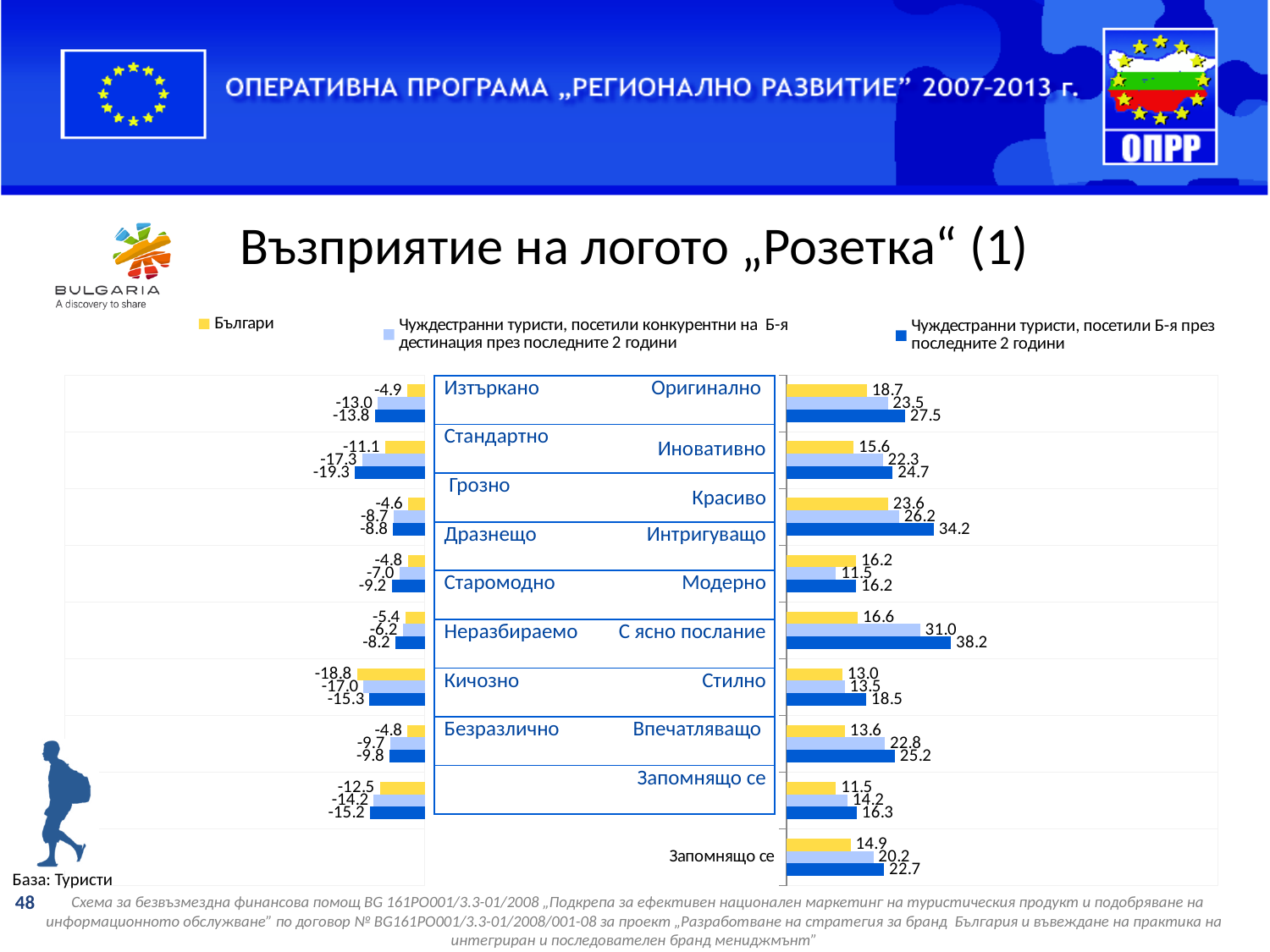
In the right-hand chart, what is the value for Българи for Оригинално? 18.7 Which series is shown in yellow according to the legend? Българи What kind of chart is used on the slide to show perception of the "Розетка" logo? bar chart How many series does the legend list? 3 In the left-hand chart (negative attributes), what is the lowest (most negative) value shown? -19.3 In the right-hand chart (positive attributes), what is the highest value shown? 38.2 In the right-hand chart, what is the value for Българи in the bottom row labelled Запомнящо се? 14.9 In the right-hand chart, what is the value for Чуждестранни туристи, посетили Б-я през последните 2 години for Оригинално? 27.5 In the right-hand chart, what is the difference between the value for Чуждестранни туристи, посетили Б-я през последните 2 години and the value for Българи for Оригинално? 8.8 In the right-hand chart, what is the value for Чуждестранни туристи, посетили Б-я през последните 2 години in the bottom row labelled Запомнящо се? 22.7 In the right-hand chart, for Оригинално, which series has the larger value: Българи or Чуждестранни туристи, посетили Б-я през последните 2 години? Чуждестранни туристи, посетили Б-я през последните 2 години